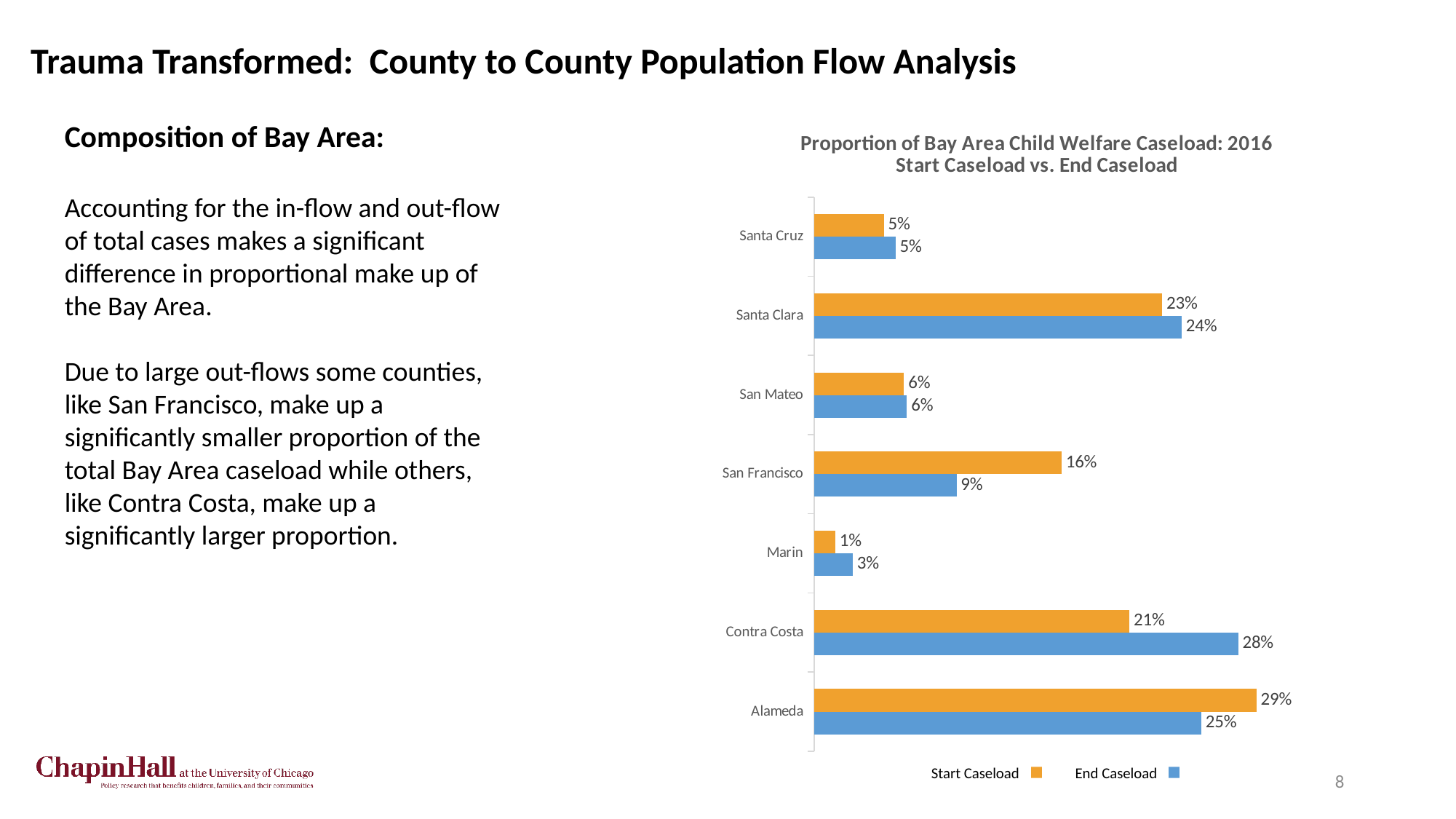
How many counties are shown in the chart? 7 What is the difference between the Start Caseload and End Caseload values for San Francisco? 7% What is the Start Caseload value for San Francisco? 16% What kind of chart is shown on the slide? Bar chart Which county has the lowest End Caseload proportion? Marin What is the End Caseload value for Marin? 3% How many series does the legend list? 2 What is the difference between the End Caseload and Start Caseload values for Contra Costa? 7% What colour represents the End Caseload series? Blue Which is larger for Alameda, the Start Caseload or the End Caseload? Start Caseload What is the End Caseload value for Contra Costa? 28% Which county has the highest Start Caseload proportion? Alameda